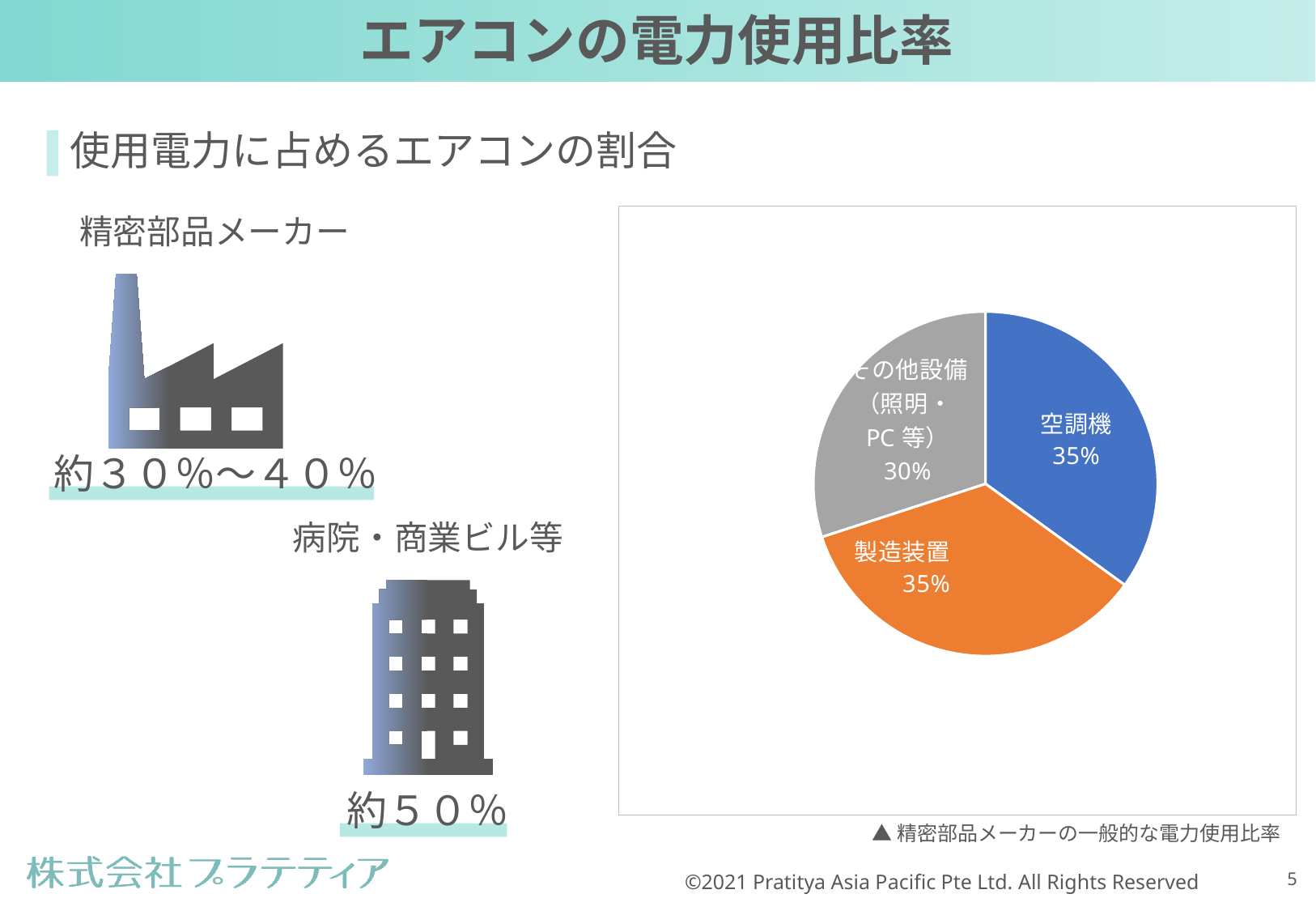
What percentage does the 空調機 slice show in the pie chart? 35% What share of the pie does 製造装置 account for? 35% What percentage does the その他設備（照明・PC 等） slice show in the pie chart? 30% Which slice of the pie chart is the smallest? その他設備（照明・PC 等） How many slices does the pie chart have? 3 By how many percentage points does 製造装置 exceed その他設備（照明・PC 等） in the pie chart? 5 Which is larger in the pie chart, 空調機 or その他設備（照明・PC 等）? 空調機 What percentage does the 製造装置 slice show in the pie chart? 35% What kind of chart is shown on the slide? pie chart What colour is the 空調機 slice in the pie chart? blue What does the caption below the pie chart say the chart represents? 精密部品メーカーの一般的な電力使用比率